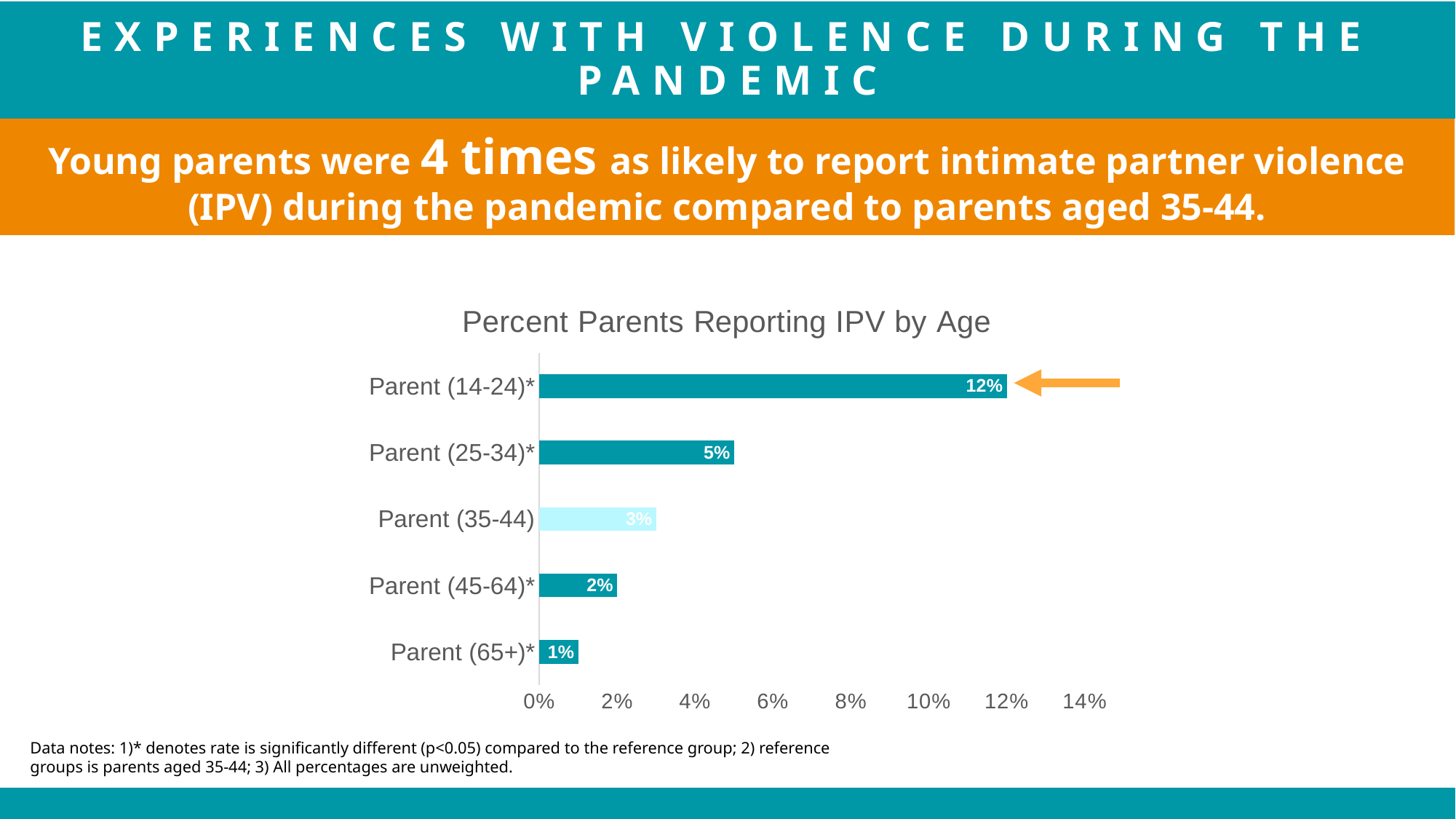
Is the value for Parent (14-24)* greater or less than 10%? greater What is the difference between the values for Parent (14-24)* and Parent (35-44)? 9% What percent of parents aged 35-44 reported IPV? 3% Which age group has the highest percent of parents reporting IPV? Parent (14-24)* What is the value for Parent (65+)*? 1% What is the title of the chart? Percent Parents Reporting IPV by Age What is the value for Parent (25-34)*? 5% How many age groups are shown in the chart? 5 What percent of parents aged 14-24 reported IPV? 12% Which is larger, the value for Parent (25-34)* or Parent (45-64)*? Parent (25-34)* Which age group has the lowest percent of parents reporting IPV? Parent (65+)* What kind of chart is shown on the slide? bar chart